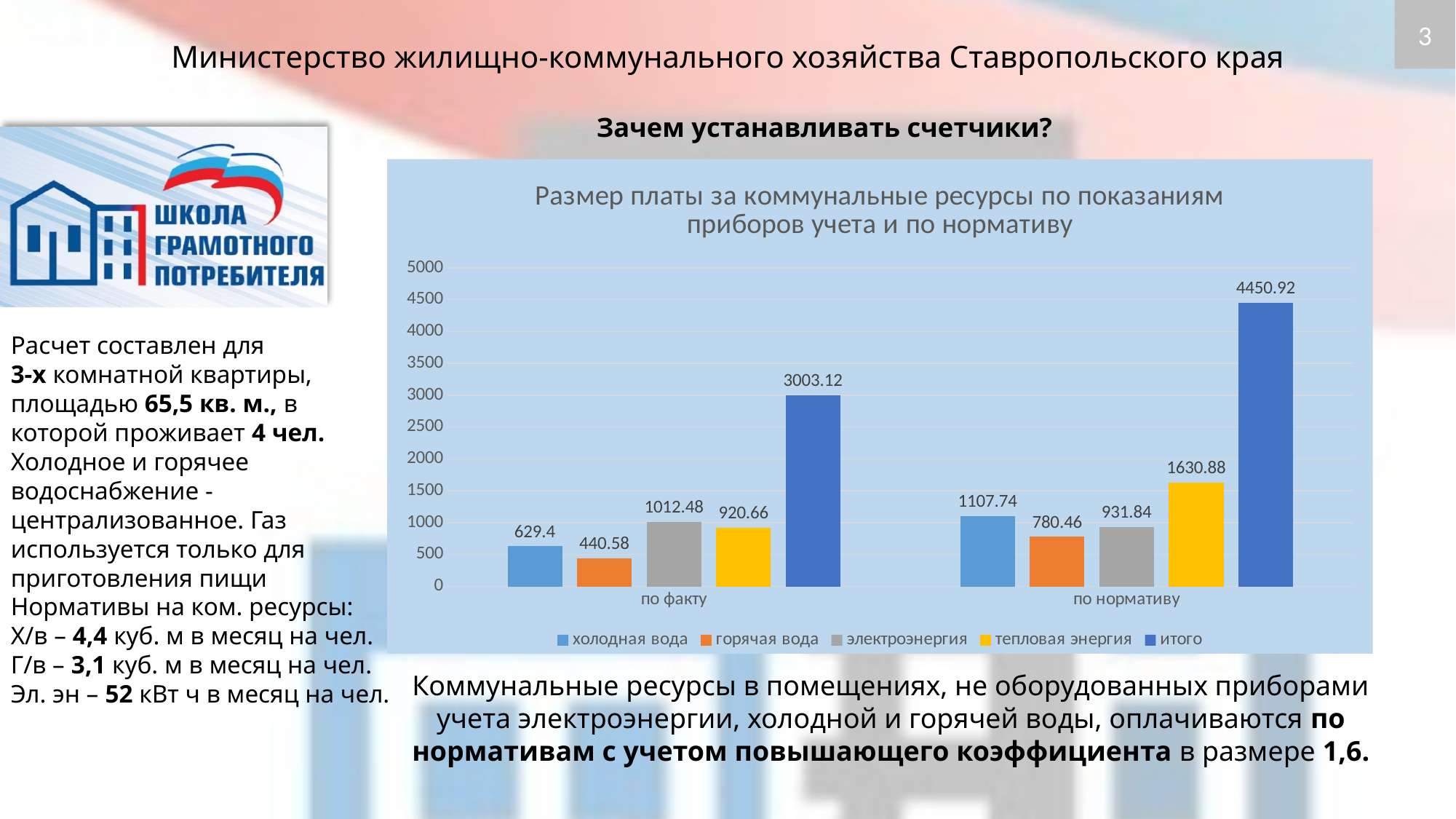
Сколько категорий показано по оси X диаграммы? 2 На сколько значение «холодная вода» по нормативу больше, чем по факту? 478.34 На сколько значение «итого» по нормативу больше значения «итого» по факту? 1447.8 Что больше: «электроэнергия» по факту или «электроэнергия» по нормативу? по факту Как называется диаграмма на слайде? Размер платы за коммунальные ресурсы по показаниям приборов учета и по нормативу Сколько рядов данных перечислено в легенде диаграммы? 5 Какой ряд имеет наименьшее значение в категории «по нормативу»? горячая вода Каково значение «тепловая энергия» для категории «по нормативу»? 1630.88 Каково значение «горячая вода» для категории «по факту»? 440.58 Какой тип диаграммы показан на слайде? столбчатая (bar chart) Какой ряд имеет наибольшее значение в категории «по факту»? итого Каково значение «итого» для категории «по факту»? 3003.12